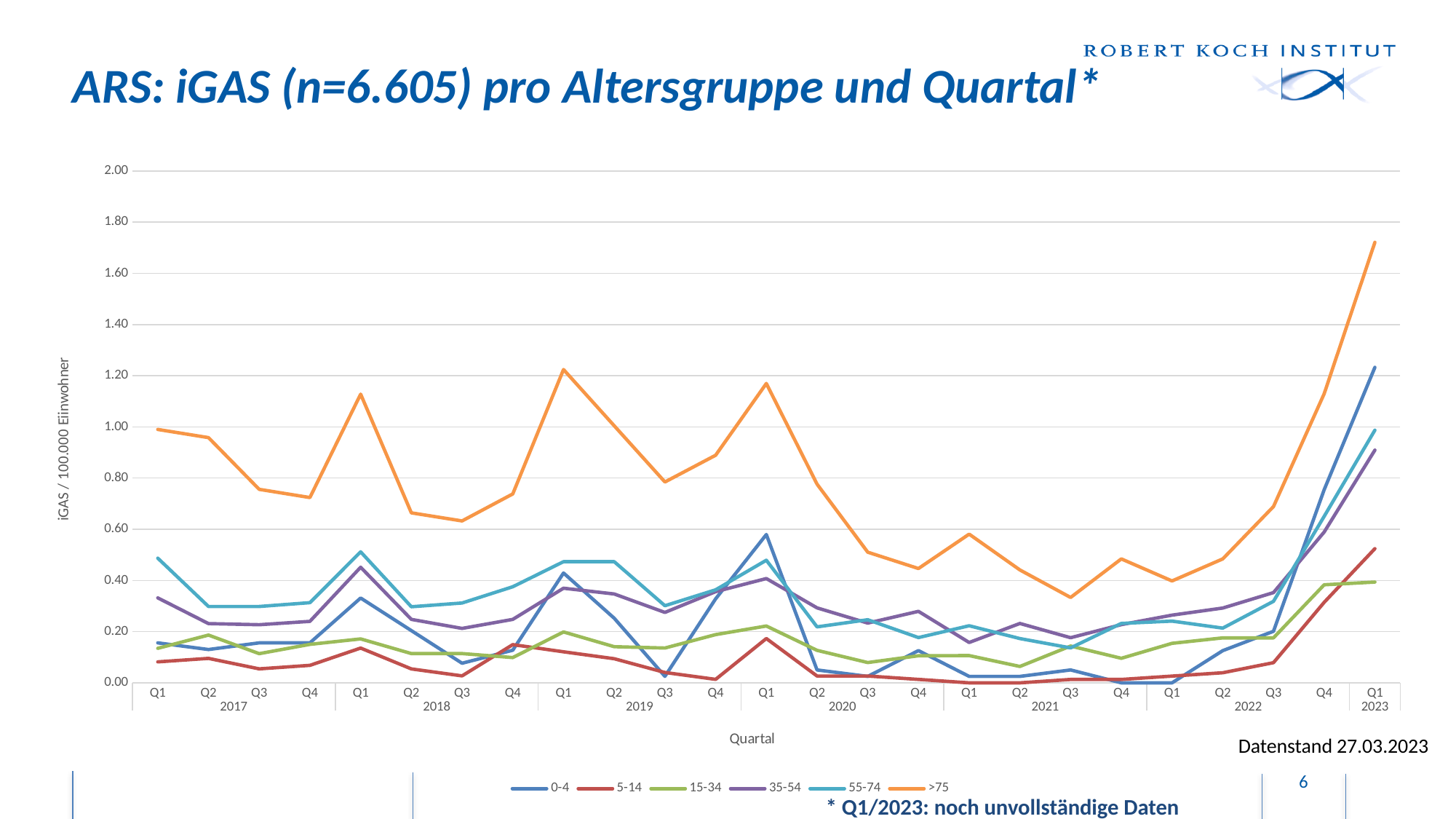
Is the value for the >75 age group in Q3 2021 greater or less than 0.40? less Which age group has the lowest value in Q1 2023? 15-34 In Q1 2020, which is larger: the value for 0-4 or the value for 55-74? 0-4 How many series does the legend list? 6 Is the value for the 0-4 age group in Q1 2023 greater or less than 1.00? greater Is the value for the >75 age group in Q1 2023 greater or less than 1.60? greater In which quarter does the >75 series reach its highest value? Q1 2023 What kind of chart is shown on the slide? line chart Does the >75 series rise or fall from Q3 2021 to Q1 2023? rise What is the label of the y axis? iGAS / 100.000 Eiinwohner Which age group has the highest value in Q1 2023? >75 How many quarters are plotted along the x axis? 25